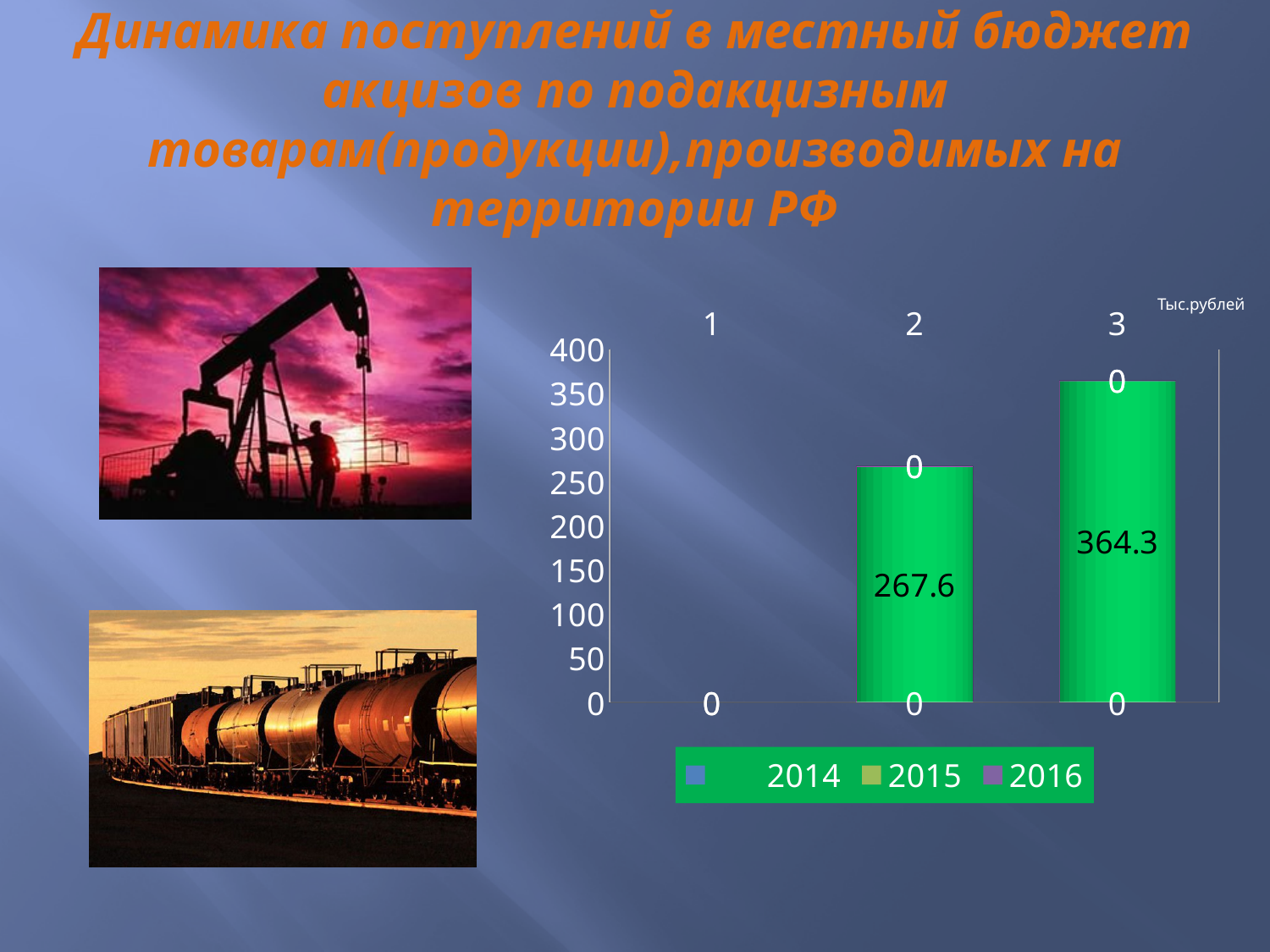
What value is shown for category 1? 0 What value is labelled on the bar for category 2? 267.6 What kind of chart is shown on the slide? bar chart Which is larger, the value for category 2 or the value for category 3? category 3 How many series does the legend list? 4 How many categories are shown on the x axis? 3 Is the value for category 2 greater or less than 250? greater Which category has the lowest value? 1 What is the difference between the values for category 3 and category 2? 96.7 What value is labelled on the bar for category 3? 364.3 Which category has the highest bar? 3 Do the values rise or fall from category 1 to category 3? rise